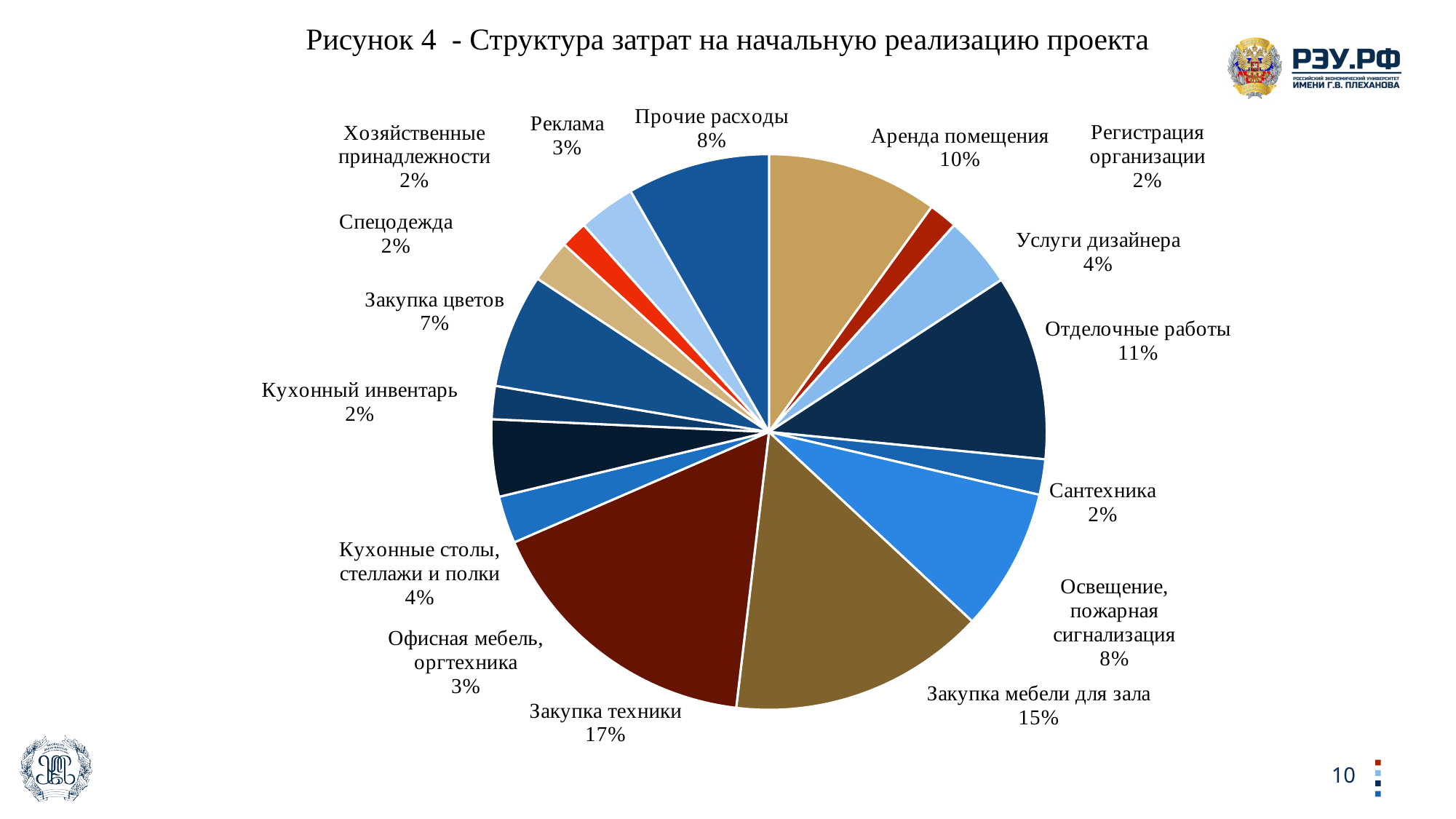
Which is larger: "Услуги дизайнера" or "Сантехника"? Услуги дизайнера What kind of chart is shown on the slide? Pie chart What is the difference between the shares of "Закупка техники" and "Закупка мебели для зала"? 2% Which is larger: "Отделочные работы" or "Аренда помещения"? Отделочные работы What is the combined share of "Прочие расходы" and "Реклама"? 11% What percentage is shown for "Аренда помещения"? 10% How many categories (slices) does the pie chart contain? 16 Which category has the largest share of the pie? Закупка техники What share does "Закупка цветов" have? 7% What is the value for "Отделочные работы"? 11% What is the title of the chart? Рисунок 4 - Структура затрат на начальную реализацию проекта What share of costs is attributed to "Закупка техники"? 17%